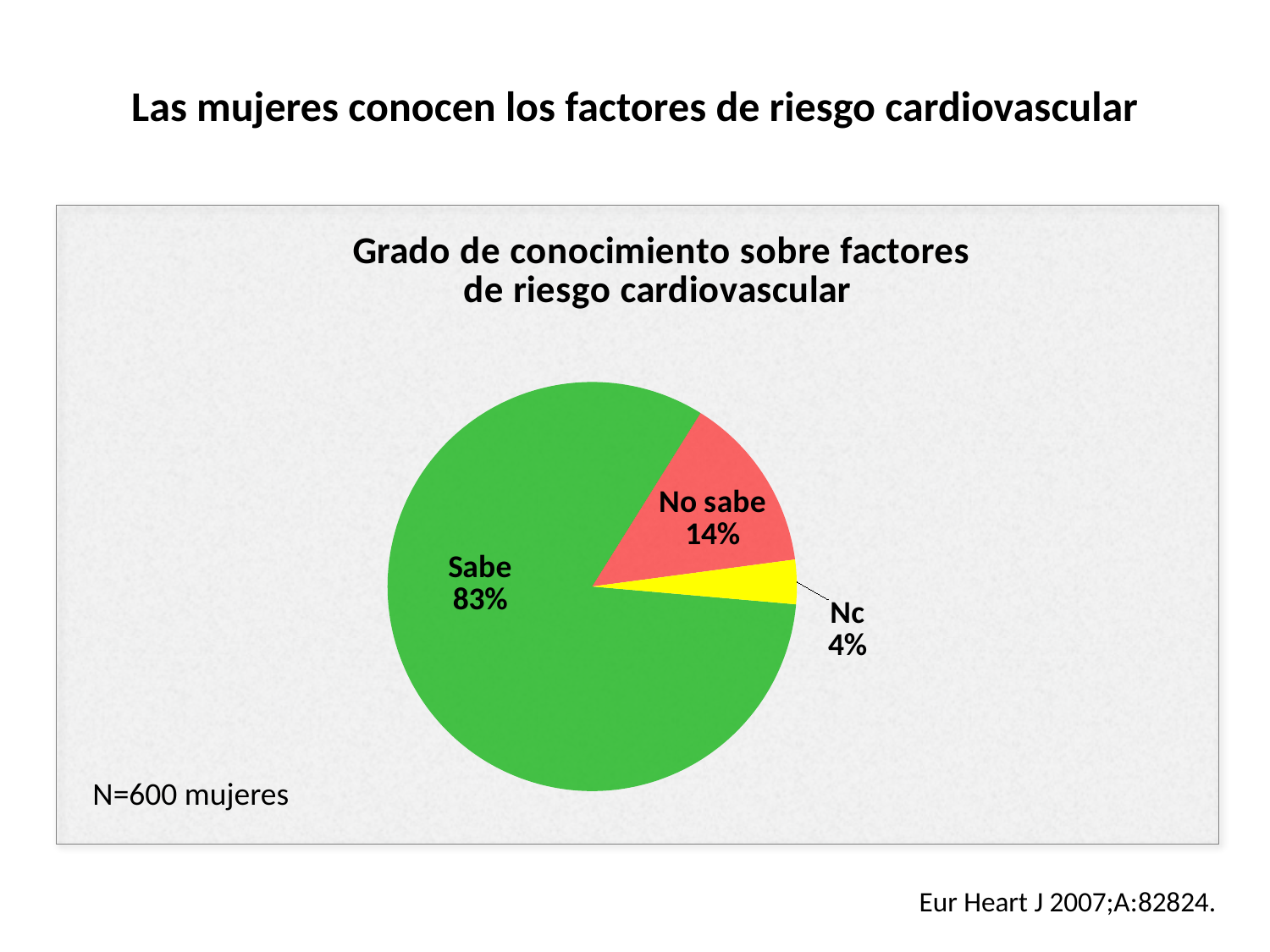
What is the difference in percentage points between "Sabe" and "No sabe"? 69 What percentage of the pie corresponds to "Sabe"? 83% What percentage of the pie corresponds to "Nc"? 4% How many slices does the pie chart have? 3 What is the sample size (N) stated on the chart? N=600 mujeres Which slice of the pie is the smallest? Nc Which is larger, the "No sabe" slice or the "Nc" slice? No sabe What colour is the "Sabe" slice? green What is the title of the chart? Grado de conocimiento sobre factores de riesgo cardiovascular Which slice of the pie is the largest? Sabe What type of chart is shown on the slide? pie chart What percentage of the pie corresponds to "No sabe"? 14%